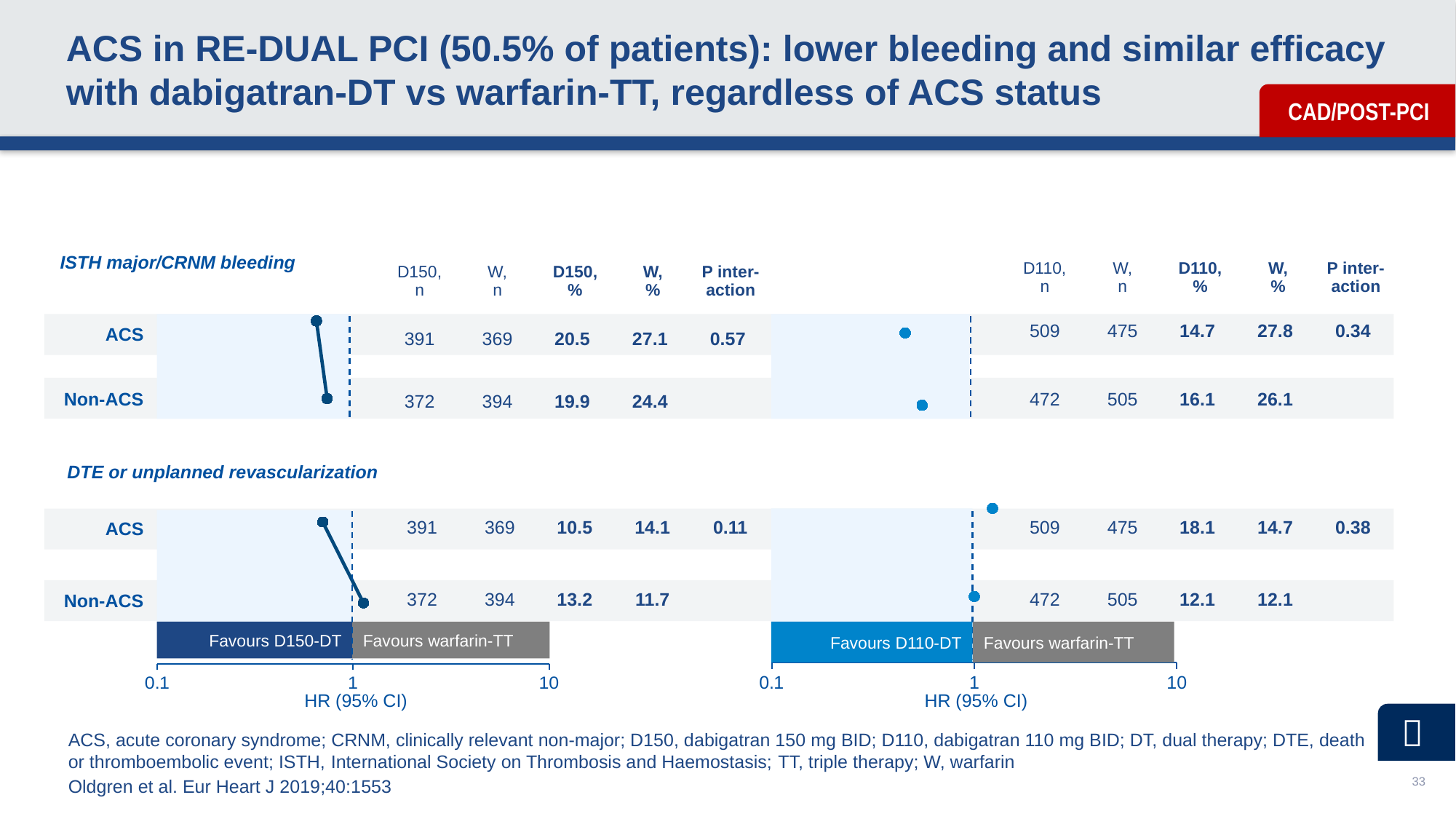
What is the x-axis label of the charts? HR (95% CI) What kind of chart is used on this slide to display the hazard ratios? Forest plot In the DTE or unplanned revascularization section of the right (D110 vs warfarin) chart, which is larger for ACS patients: the D110 % or the W %? D110 % In the left (D150 vs warfarin) chart, is the hazard ratio for ISTH major/CRNM bleeding in ACS patients greater or less than 1? less In the ISTH major/CRNM bleeding section of the left (D150 vs warfarin) chart, what is the D150 % for ACS patients? 20.5 In the DTE or unplanned revascularization section of the left (D150 vs warfarin) chart, what is the difference between the D150 % and the W % for Non-ACS patients? 1.5 How many patient subgroups are plotted for each outcome in the charts? 2 In the ISTH major/CRNM bleeding section of the right (D110 vs warfarin) chart, what is the W % for Non-ACS patients? 26.1 In the right (D110 vs warfarin) chart, is the hazard ratio for DTE or unplanned revascularization in ACS patients greater or less than 1? greater In the right (D110 vs warfarin) chart, what is the D110 n for ACS patients? 509 In the ISTH major/CRNM bleeding section of the left (D150 vs warfarin) chart, what is the difference between the W % and the D150 % for ACS patients? 6.6 In the left (D150 vs warfarin) chart, what is the P interaction value for ISTH major/CRNM bleeding? 0.57